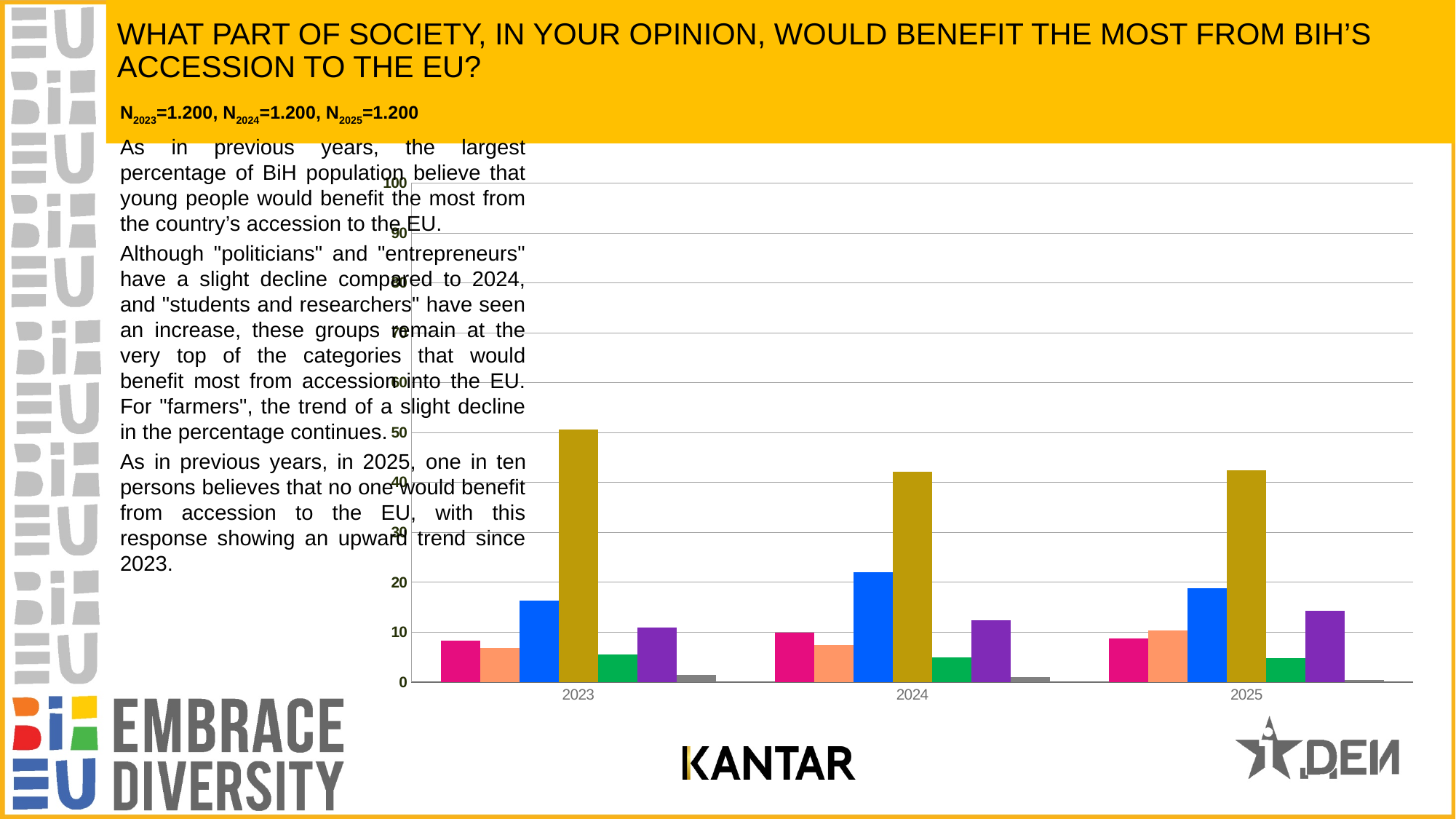
How many bars are plotted for each year in the chart? 7 In which year is the blue bar the highest? 2024 Is the value of the gold bar for 2025 greater or less than 40? greater What kind of chart is shown on the slide? bar chart What is the highest value shown on the chart's vertical axis? 100 How many years are shown on the x axis of the chart? 3 Is the value of the blue bar for 2024 greater or less than 30? less Is the value of the green bar for 2023 greater or less than 10? less In 2024, which is larger: the gold bar or the blue bar? the gold bar In which year is the gold (tallest) bar the highest? 2023